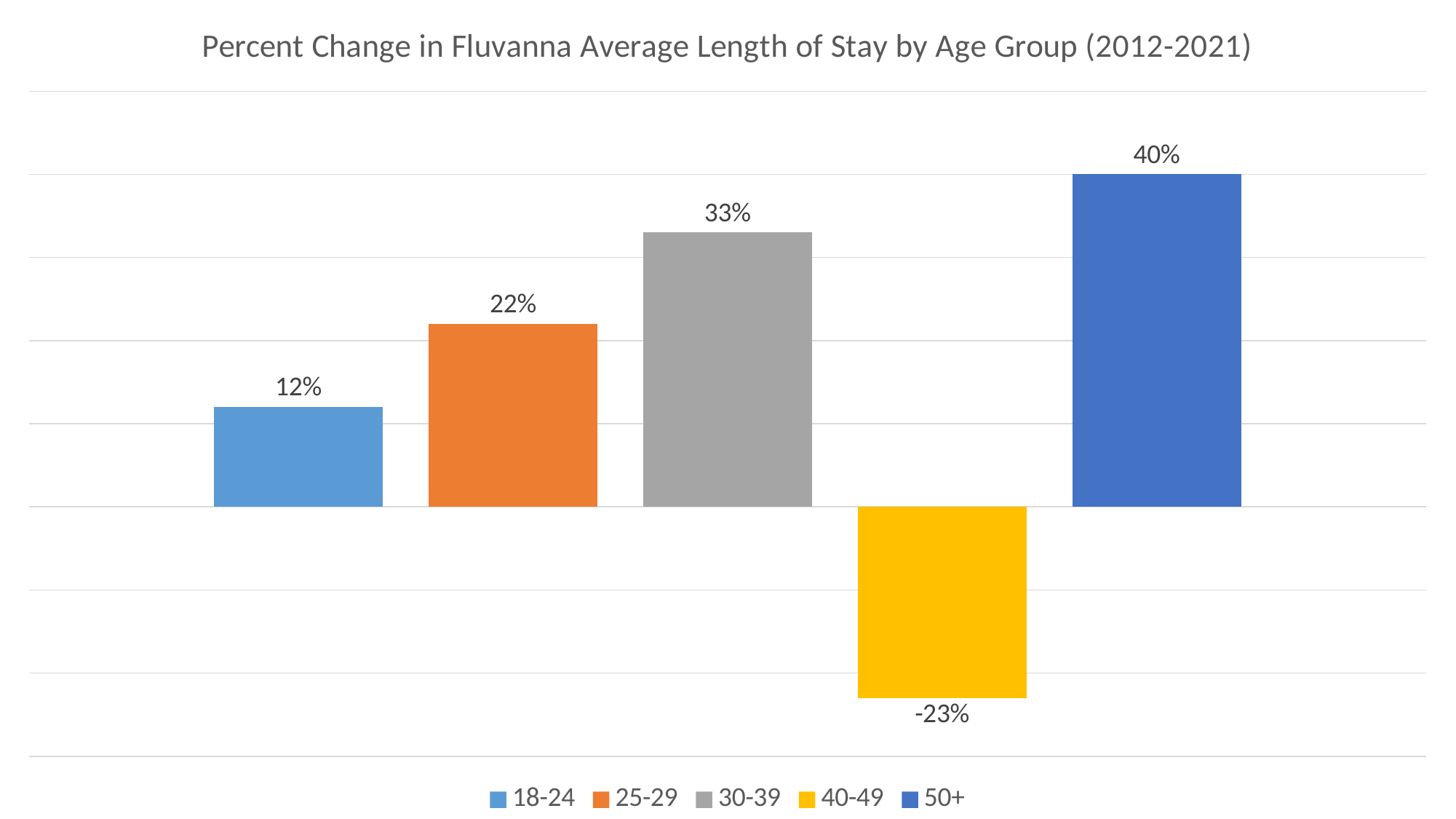
How many age groups are shown in the chart? 5 Which age group has the lowest percent change in average length of stay? 40-49 Which age group has the highest percent change in average length of stay? 50+ What is the percent change in average length of stay for the 50+ age group? 40% Which age group has a larger percent change, 25-29 or 30-39? 30-39 What is the percent change in average length of stay for the 40-49 age group? -23% How many entries does the legend list? 5 What is the difference between the percent change for the 30-39 age group and the 25-29 age group? 11% What type of chart is shown on the slide? Bar chart Which age group is the only one with a negative percent change? 40-49 What is the title of the chart? Percent Change in Fluvanna Average Length of Stay by Age Group (2012-2021) What is the percent change in average length of stay for the 18-24 age group? 12%